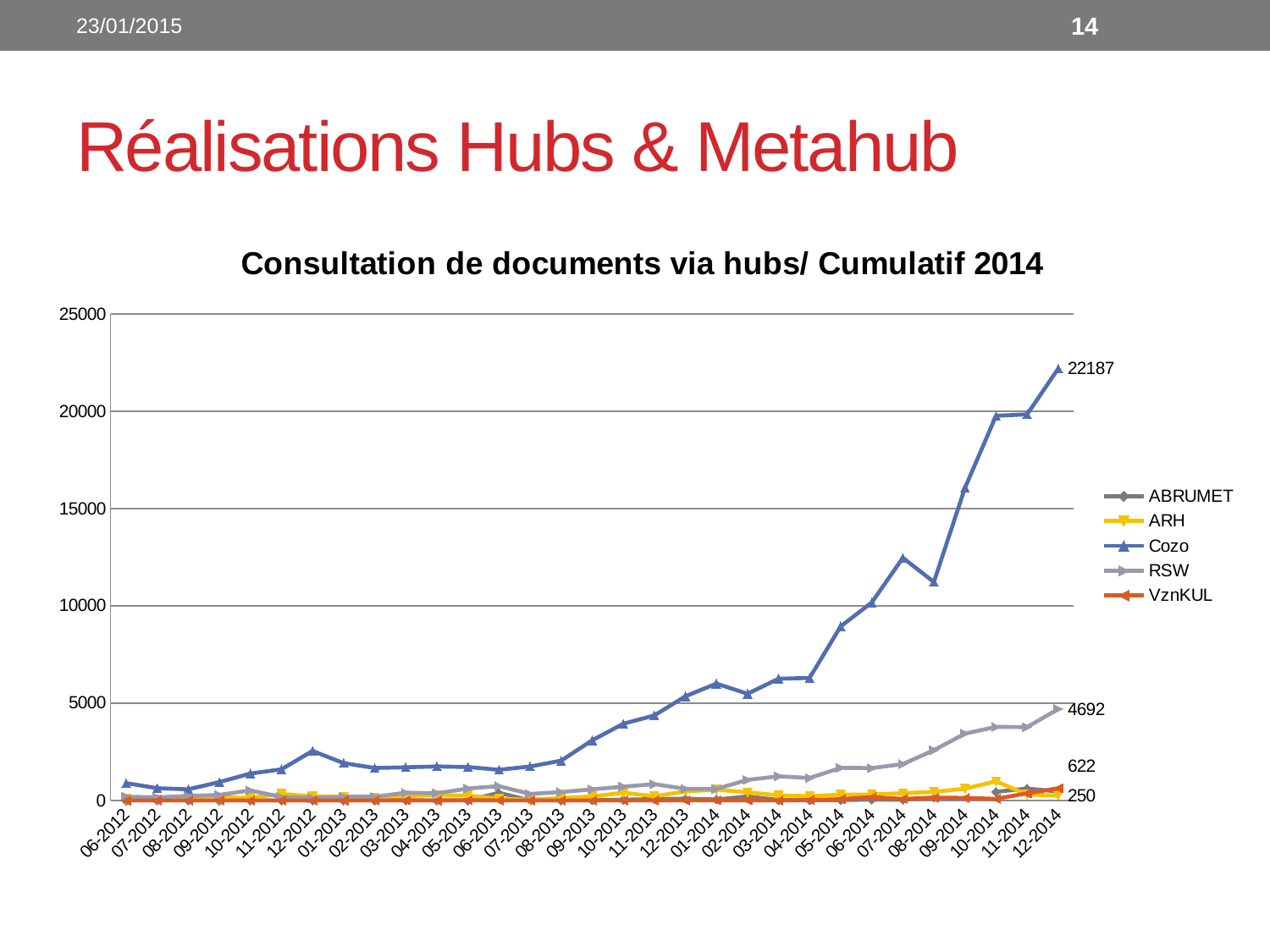
What is the title of the chart? Consultation de documents via hubs/ Cumulatif 2014 Which is larger at 12-2014, the value for Cozo or the value for RSW? Cozo What is the value for RSW at 12-2014? 4692 Which series are listed in the legend? ABRUMET, ARH, Cozo, RSW, VznKUL Which series has the highest value at 12-2014? Cozo Is the value for Cozo at 12-2014 greater or less than 20000? greater Does the Cozo line generally rise or fall from 06-2012 to 12-2014? rise How many series does the legend list? 5 Is the value for Cozo at 05-2014 greater or less than 10000? less What is the value for Cozo at 12-2014? 22187 What is the difference between the Cozo and RSW values at 12-2014? 17495 What type of chart is shown on the slide? line chart